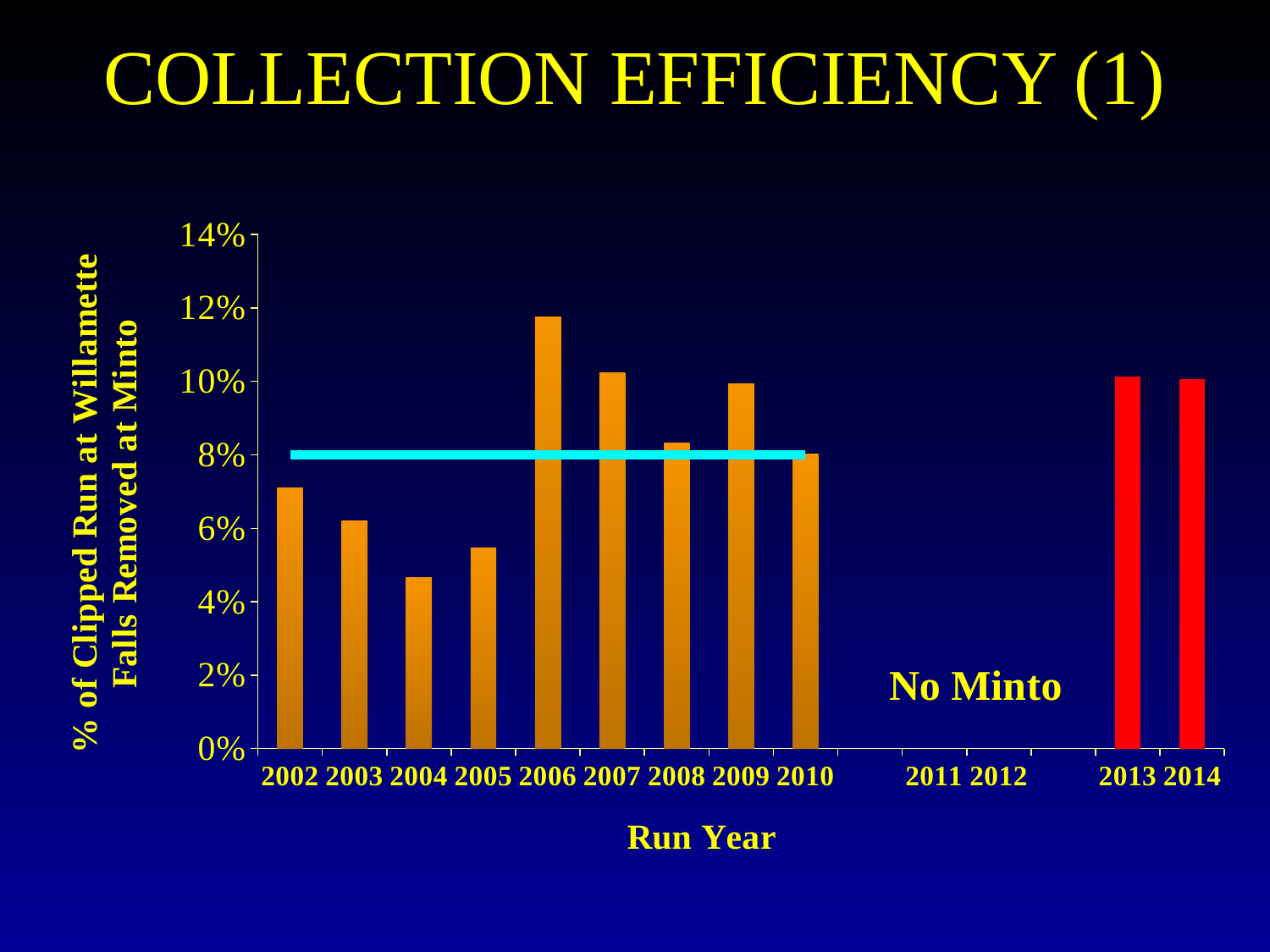
What label is shown in place of bars for 2011 and 2012? No Minto Is the value for 2006 greater or less than 10%? greater Is the value for 2005 greater or less than 6%? less Which run year has the highest percentage of clipped run removed at Minto? 2006 Which run year has the lowest percentage of clipped run removed at Minto? 2004 How many run years have a bar plotted on the chart? 11 Is the value for 2013 greater or less than 8%? greater Do the values rise or fall from 2002 to 2004? fall Which year has the larger value, 2006 or 2007? 2006 What kind of chart is shown on the slide? bar chart Which year has the larger value, 2002 or 2004? 2002